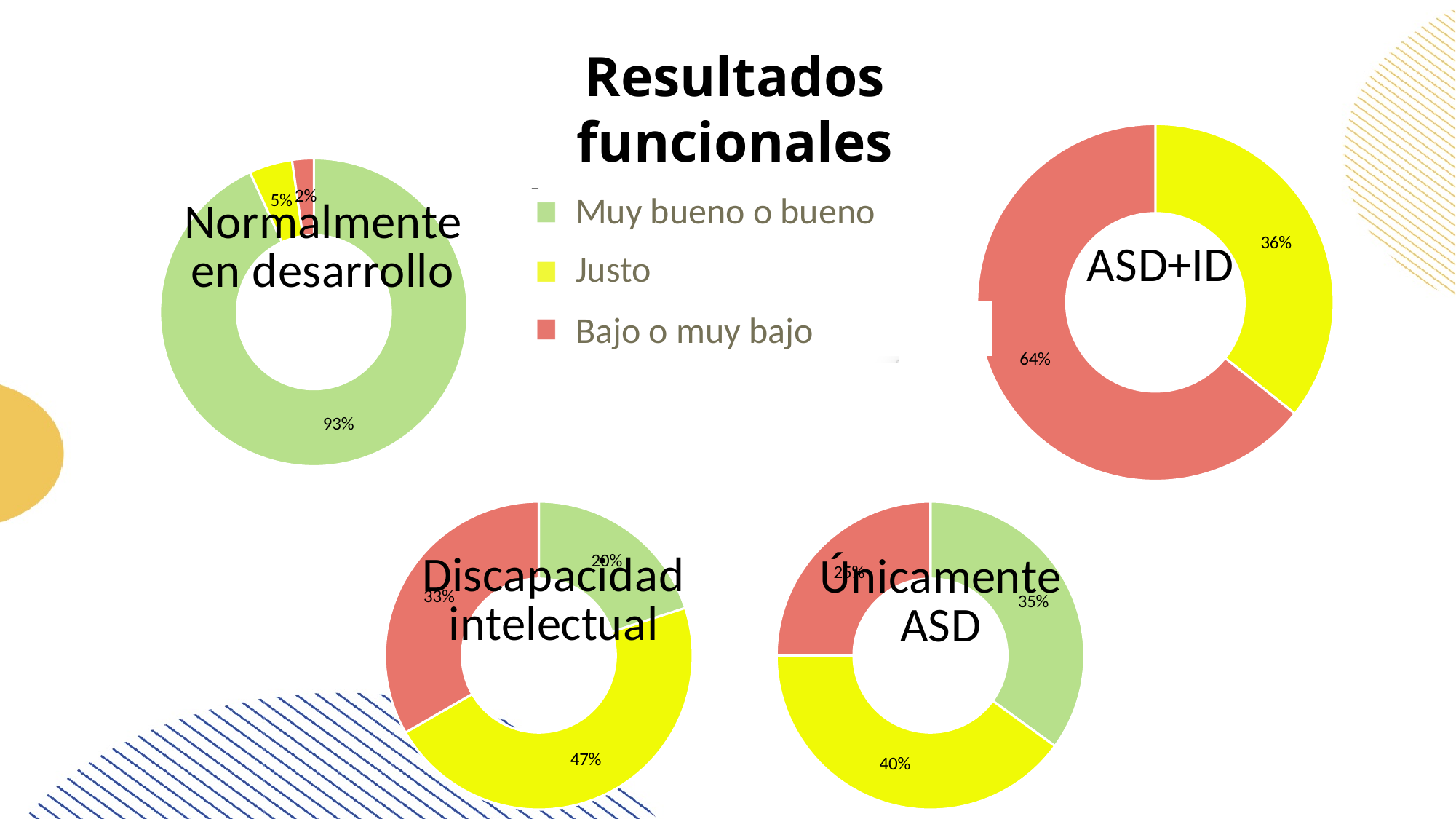
In the 'ASD+ID' chart, which category has the largest share? Bajo o muy bajo Which colour represents 'Bajo o muy bajo' in the legend? Red How many series does the legend list? 3 In the 'ASD+ID' chart, what share is 'Justo'? 36% What kind of chart is used for the 'Normalmente en desarrollo' group? Donut (pie) chart In the 'Normalmente en desarrollo' chart, what share is 'Justo'? 5% In the 'Normalmente en desarrollo' chart, what share is 'Muy bueno o bueno'? 93% In the 'Discapacidad intelectual' chart, what is the difference between the 'Justo' share and the 'Bajo o muy bajo' share? 14 percentage points In the 'Únicamente ASD' chart, which is larger, 'Justo' or 'Muy bueno o bueno'? Justo In the 'Discapacidad intelectual' chart, what share is 'Justo'? 47% In the 'Normalmente en desarrollo' chart, what share is 'Bajo o muy bajo'? 2% In the 'ASD+ID' chart, what share is 'Bajo o muy bajo'? 64%